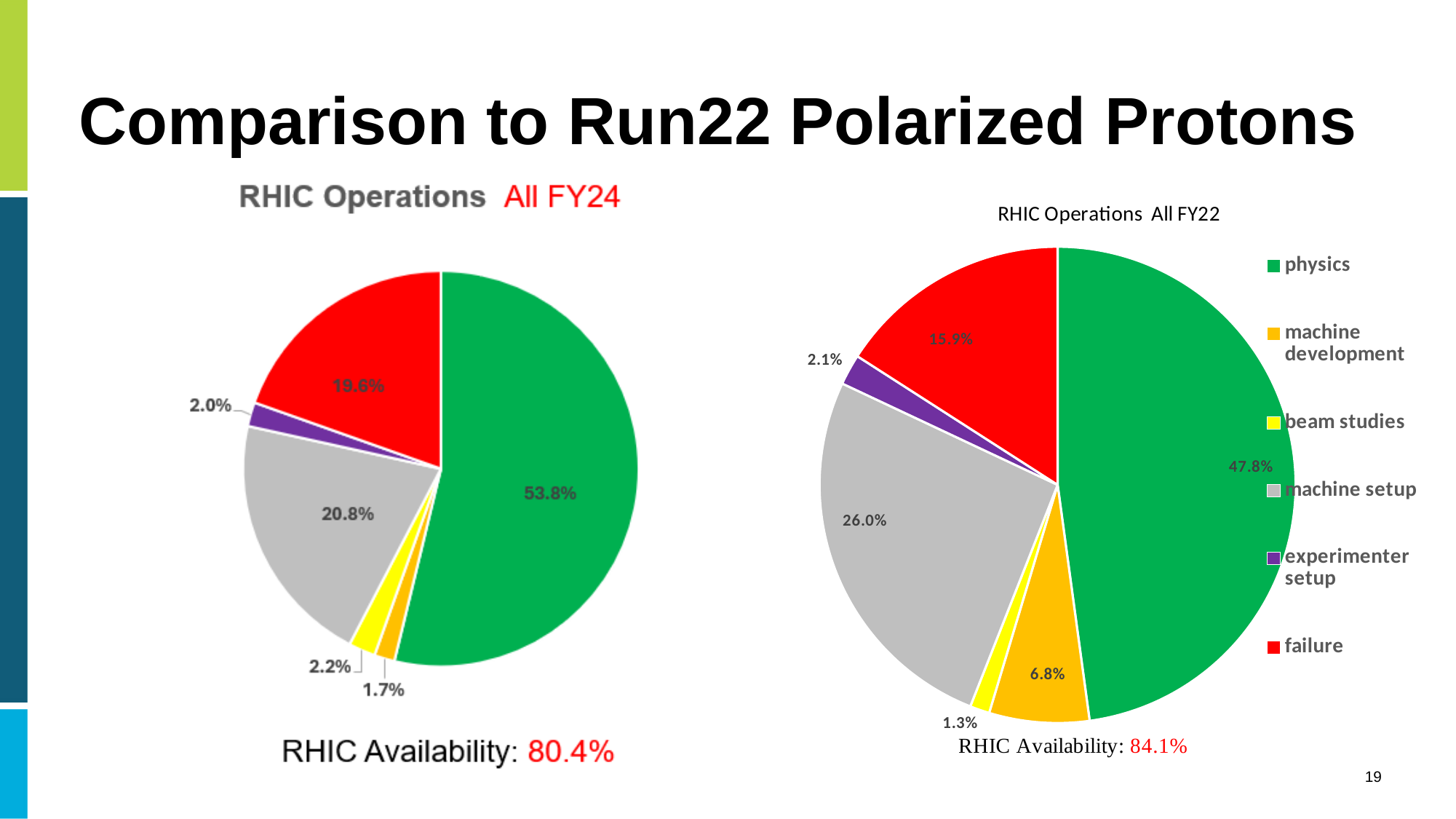
In the RHIC Operations All FY24 chart, what is the percentage of the red slice? 19.6% In the RHIC Operations All FY22 chart, what percentage is failure? 15.9% In the RHIC Operations All FY22 chart, what percentage is machine development? 6.8% In the RHIC Operations All FY24 chart, what is the percentage of the largest (green) slice? 53.8% In the RHIC Operations All FY22 chart, what is the difference between the machine setup and failure percentages? 10.1% What kind of chart is used on this slide? Pie chart In the RHIC Operations All FY22 chart, which category has the largest slice? physics In the RHIC Operations All FY22 chart, what percentage is machine setup? 26.0% In the RHIC Operations All FY22 chart, how many categories does the legend list? 6 In the RHIC Operations All FY22 chart, which category has the smallest slice? beam studies In the RHIC Operations All FY24 chart, what is the percentage of the grey slice? 20.8% In the RHIC Operations All FY22 chart, what share of the pie is physics? 47.8%